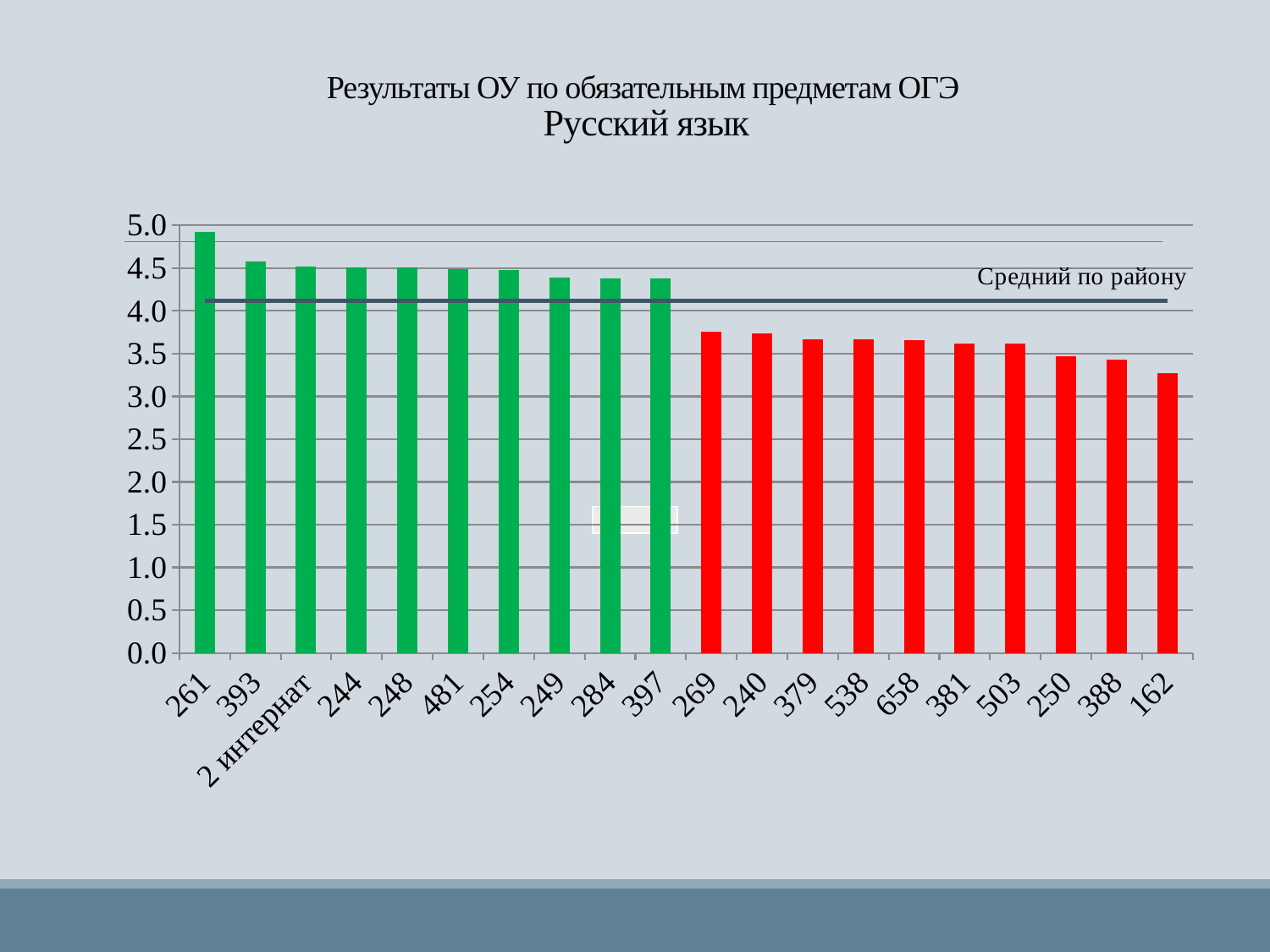
What does the horizontal line drawn across the chart represent, according to its label? Средний по району Which category has the highest bar? 261 What kind of chart is shown on the slide? Bar chart Is the value for 162 greater or less than 3.5? less How many categories (schools) are plotted along the x axis? 20 Which category has the lowest bar? 162 Do the bar values rise or fall from left to right along the x axis? Fall Is the value for 240 greater or less than 4.0? less Is the value for 261 greater or less than 4.5? greater Which has the larger value, 393 or 269? 393